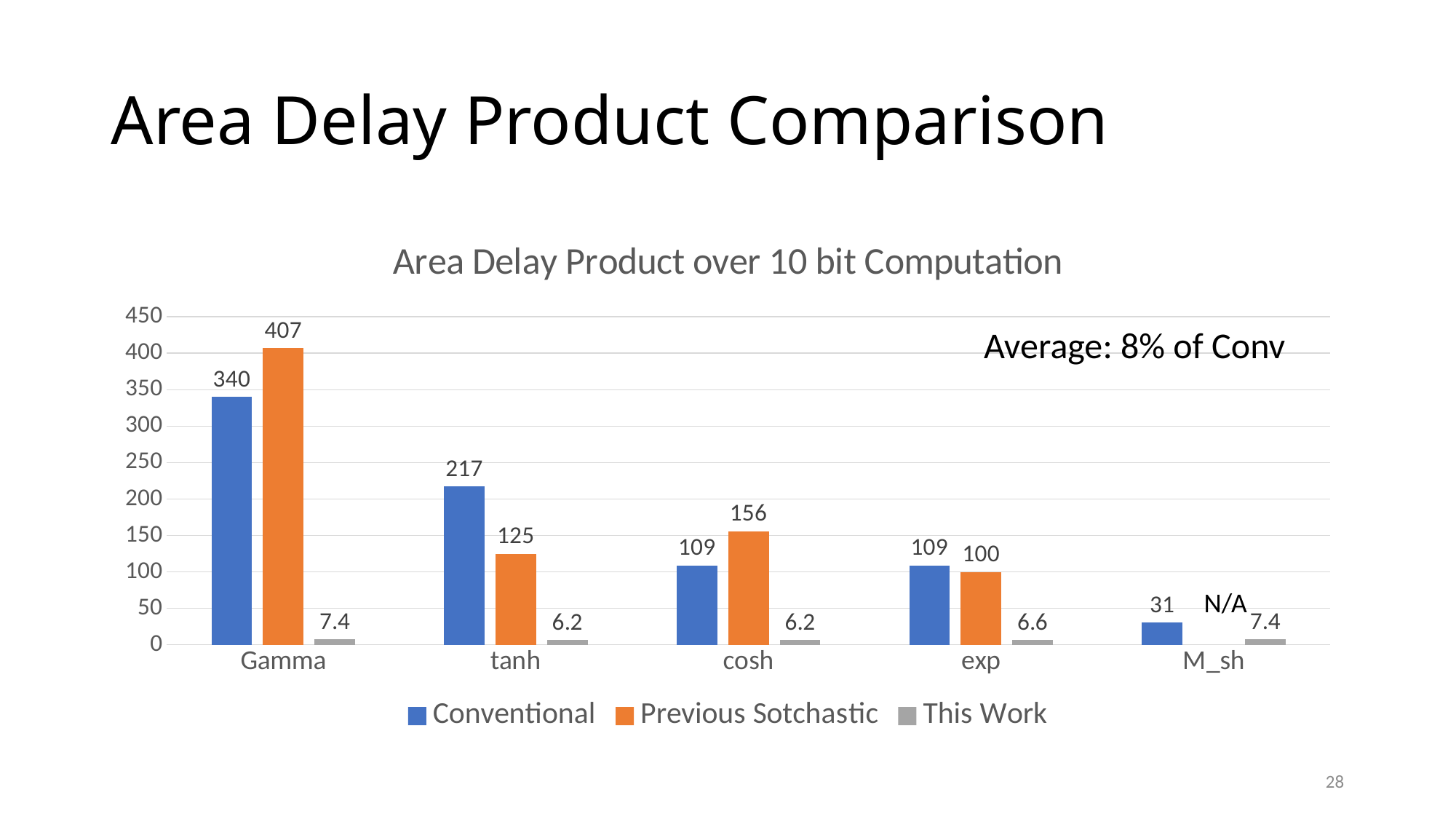
How many series does the legend list? 3 Is the Conventional value for tanh greater or less than 200? greater What kind of chart is shown? bar chart Which category has the highest Conventional value? Gamma What is the Previous Sotchastic value for cosh? 156 What is the difference between the Previous Sotchastic and Conventional values for Gamma? 67 What is the Previous Sotchastic value shown for M_sh? N/A What is the This Work value for exp? 6.6 What is the Conventional value for Gamma? 340 Which is larger for tanh, the Conventional value or the Previous Sotchastic value? Conventional Which category has the lowest Conventional value? M_sh How many categories are shown on the x axis? 5